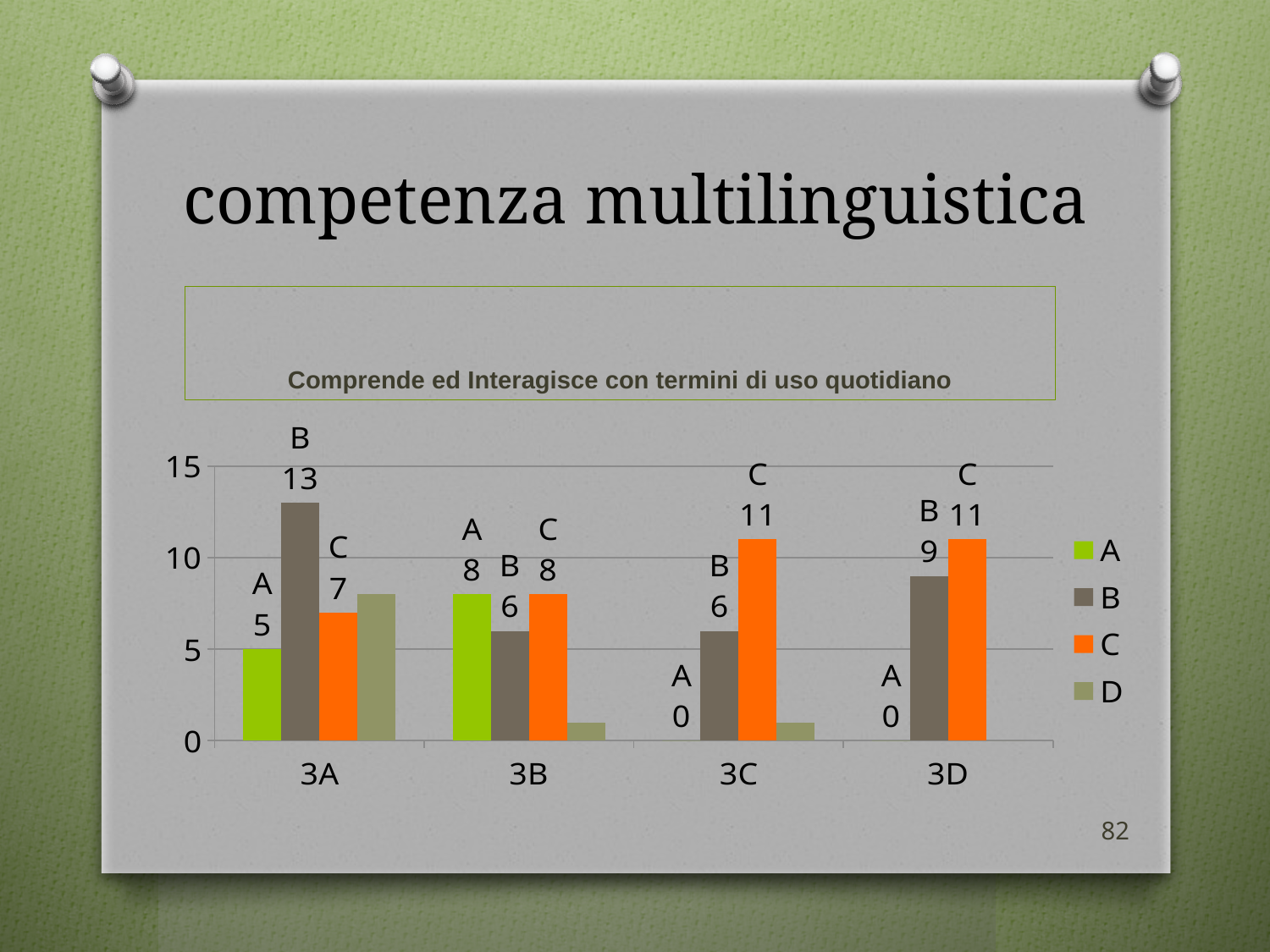
What is the value for series B in category 3A? 13 What is the value for series A in category 3D? 0 Which category has the lowest value for series C? 3A Which category has the highest value for series B? 3A What is the difference between the values for series B and series A in category 3A? 8 What is the value for series B in category 3D? 9 What is the value for series C in category 3C? 11 Is the value for series D in category 3A greater or less than 5? greater How many categories are shown on the x axis? 4 What kind of chart is shown on the slide? bar chart Which is larger in category 3B: the value for series A or the value for series B? A How many series does the legend list? 4